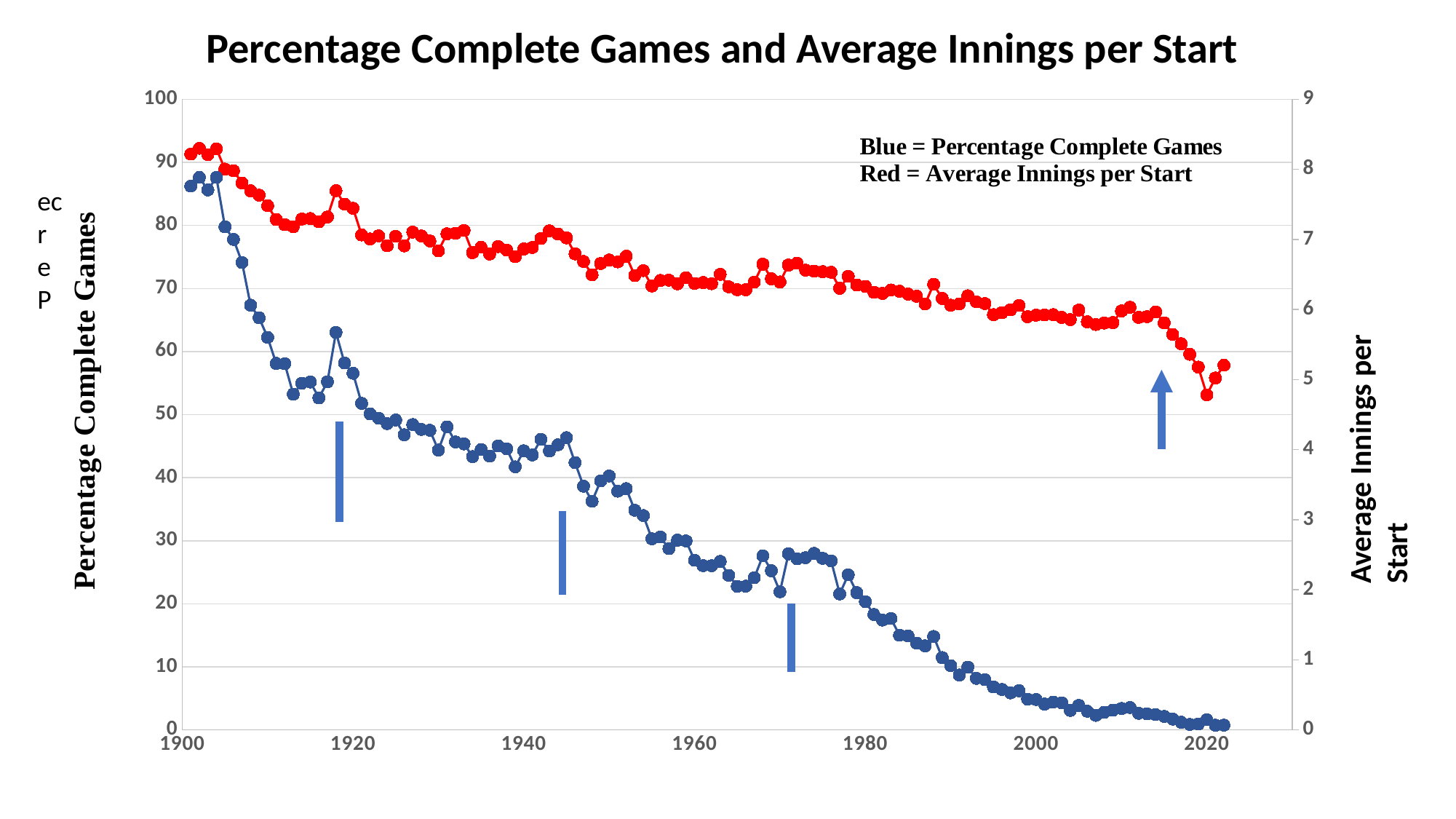
What is the title of the chart? Percentage Complete Games and Average Innings per Start Does the red Average Innings per Start series rise or fall from 1900 to 2020? fall According to the legend text, what does the red series represent? Average Innings per Start Is the Percentage Complete Games value in 1960 greater or less than 40? less Is the Percentage Complete Games value in 1900 greater or less than 80? greater How many data series does the chart plot? 2 Does the blue Percentage Complete Games series rise or fall from 1900 to 2020? fall What kind of chart is shown on the slide? line chart Is the Percentage Complete Games value in 2020 greater or less than 10? less Which year has the higher Percentage Complete Games value, 1920 or 1980? 1920